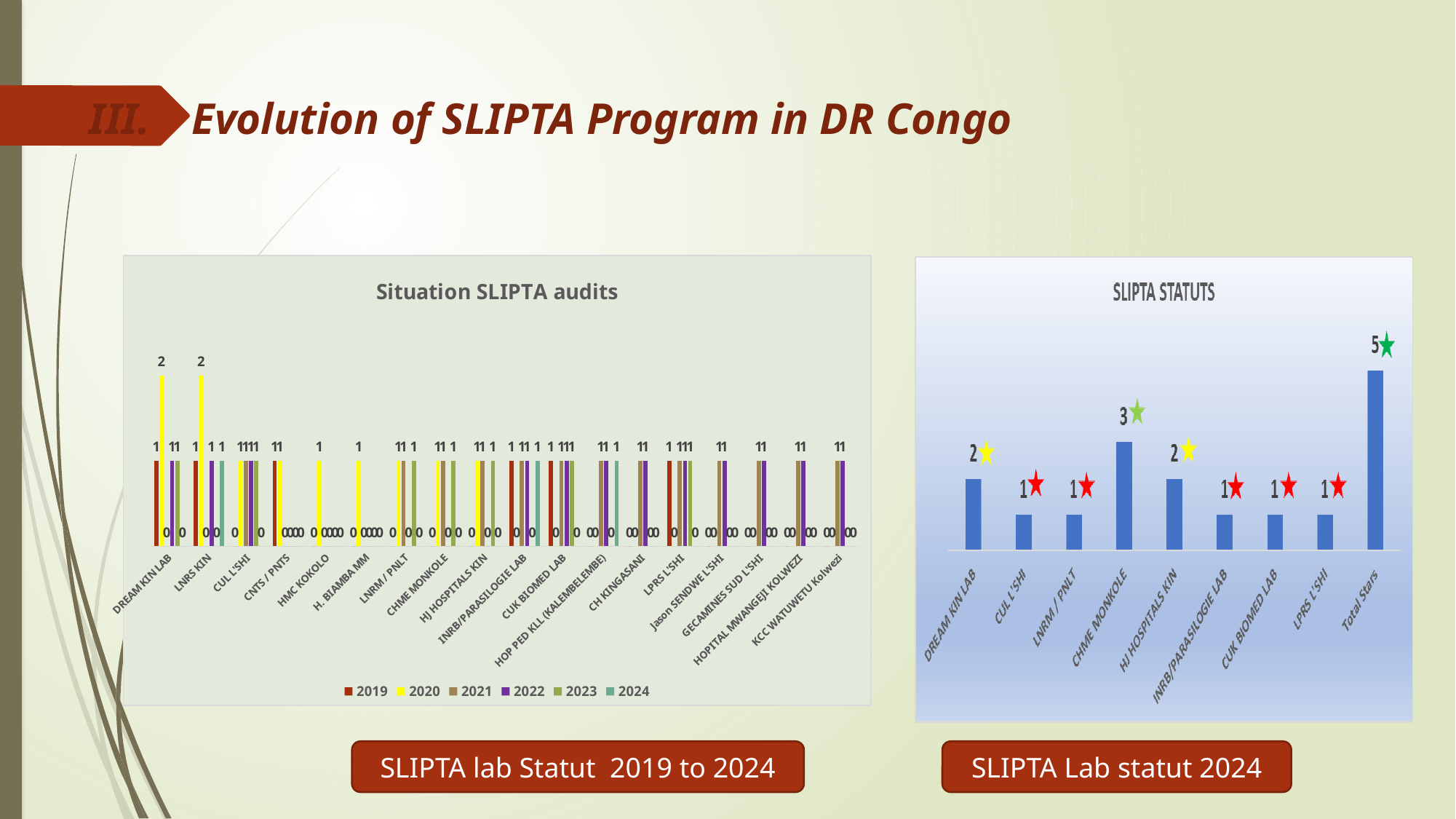
In the SLIPTA STATUTS chart on the right, what is the value for HJ HOSPITALS KIN? 2 In the SLIPTA STATUTS chart on the right, what is the value for CHME MONKOLE? 3 In the SLIPTA STATUTS chart on the right, what is the difference between the Total Stars value and the CHME MONKOLE value? 2 In the SLIPTA STATUTS chart on the right, which laboratory (excluding Total Stars) has the highest value? CHME MONKOLE How many categories are shown on the x axis of the SLIPTA STATUTS chart on the right? 9 How many laboratories are listed on the x axis of the Situation SLIPTA audits chart on the left? 18 In the SLIPTA STATUTS chart on the right, which is larger, the value for DREAM KIN LAB or the value for CUL L'SHI? DREAM KIN LAB What kind of chart is the SLIPTA STATUTS chart on the right? Bar chart How many series does the legend of the Situation SLIPTA audits chart on the left list? 6 In the SLIPTA STATUTS chart on the right, which category has the tallest bar? Total Stars In the SLIPTA STATUTS chart on the right, what is the value for DREAM KIN LAB? 2 In the Situation SLIPTA audits chart on the left, what is the 2020 value for DREAM KIN LAB? 2